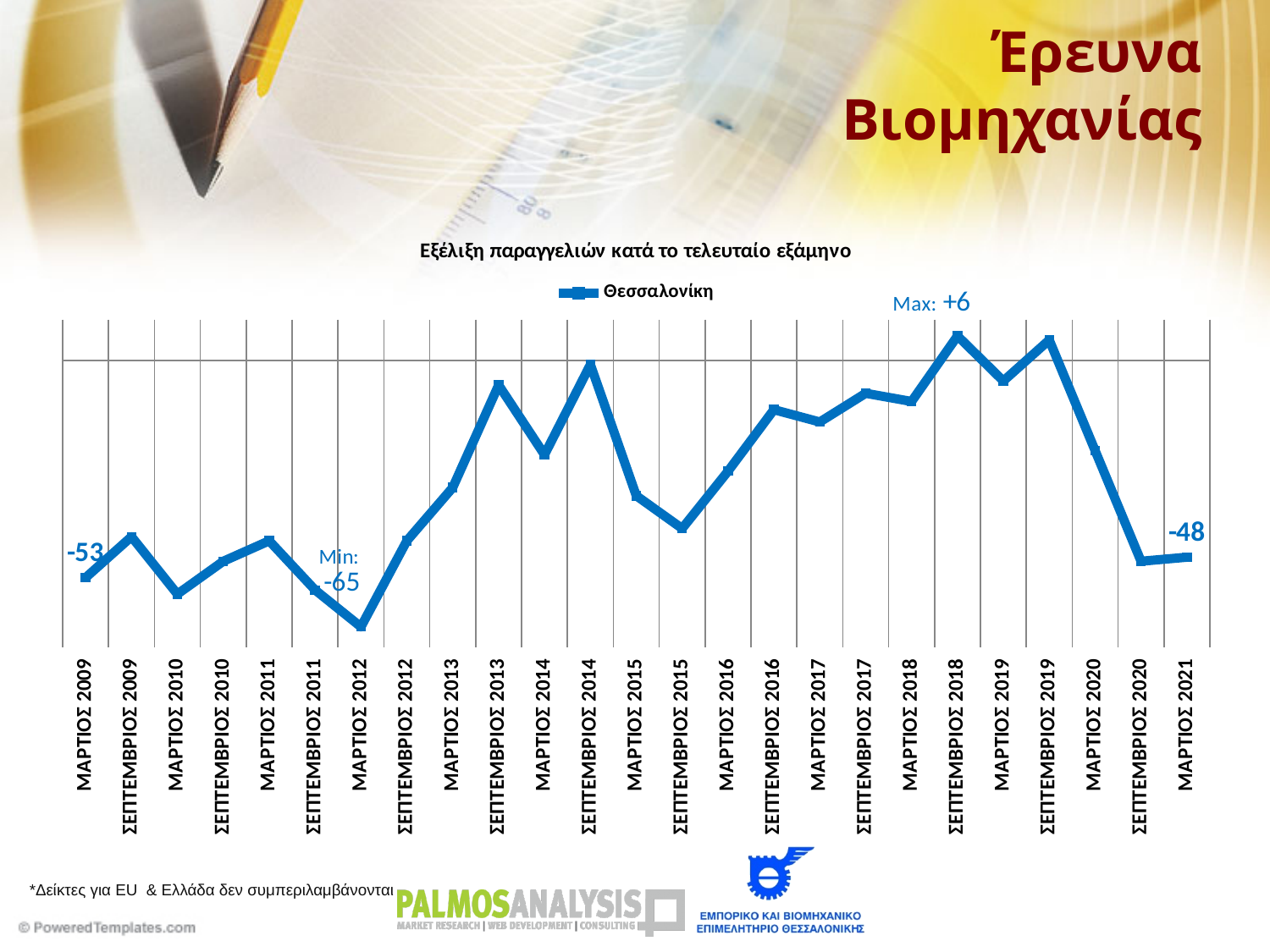
Which is larger, the value for ΜΑΡΤΙΟΣ 2009 or the value for ΜΑΡΤΙΟΣ 2021? ΜΑΡΤΙΟΣ 2021 Which period has the lowest value, and what is it? ΜΑΡΤΙΟΣ 2012, -65 What is the difference between the value for ΜΑΡΤΙΟΣ 2021 and the value for ΜΑΡΤΙΟΣ 2009? 5 What is the value for ΜΑΡΤΙΟΣ 2021? -48 How many series does the legend list? 1 What is the title of the chart? Εξέλιξη παραγγελιών κατά το τελευταίο εξάμηνο How many data points are plotted on the x axis? 25 What type of chart is shown on the slide? Line chart What is the difference between the maximum value (+6) and the minimum value (-65)? 71 Which series does the legend list? Θεσσαλονίκη Which period has the highest value, and what is it? ΣΕΠΤΕΜΒΡΙΟΣ 2018, +6 What is the value for ΜΑΡΤΙΟΣ 2009? -53